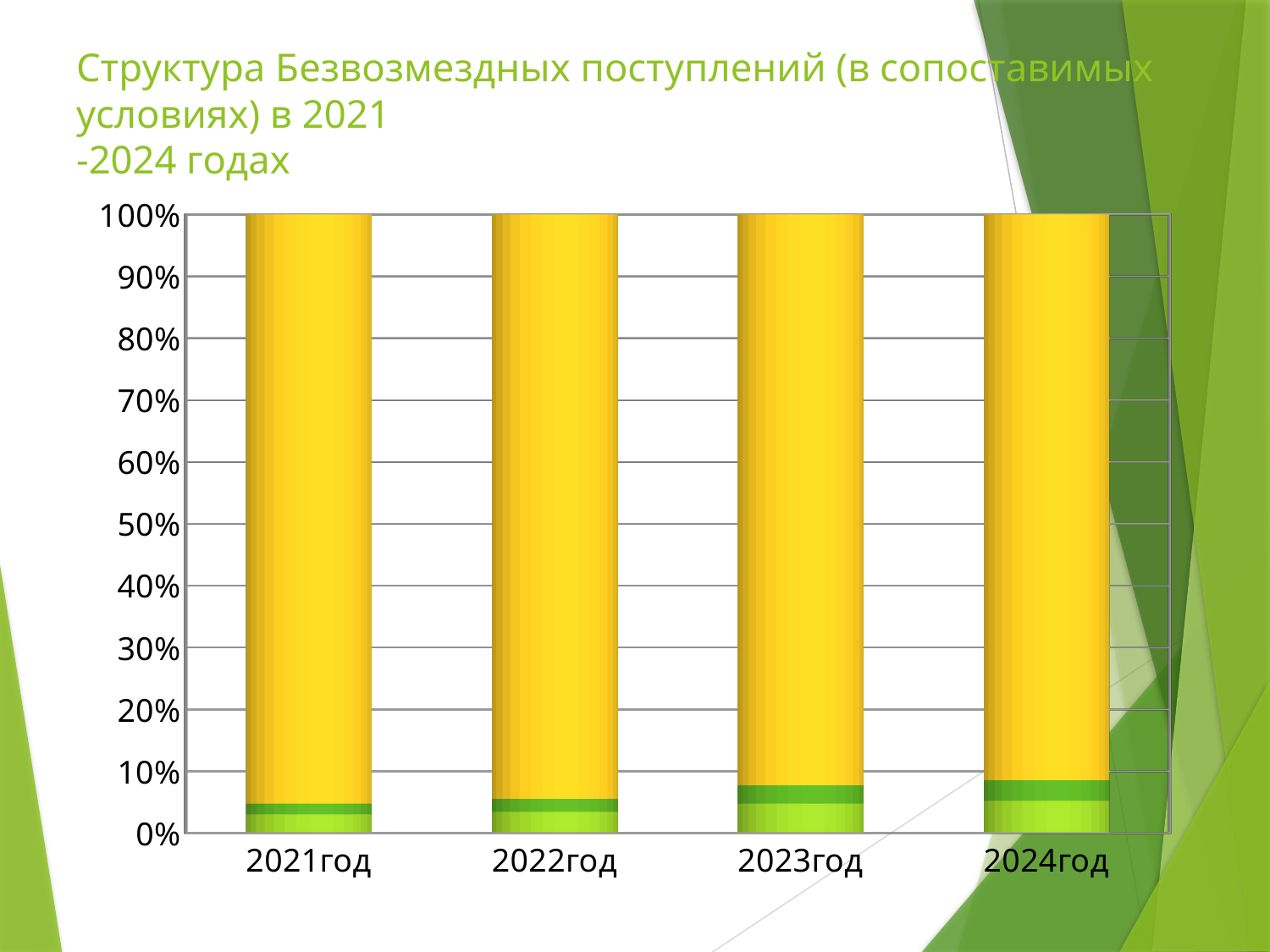
How many years (categories) are shown on the x axis of the chart? 4 Is the combined green portion of the bar for 2024год greater or less than 10%? less Does the green portion at the bottom of the bars rise or fall from 2021год to 2024год? rise What is the label of the first category on the x axis? 2021год Is the combined green portion of the bar for 2021год greater or less than 10%? less What is the highest value shown on the y axis? 100% What is the label of the last category on the x axis? 2024год Which year has the largest green portion at the bottom of its bar, 2021год or 2024год? 2024год What kind of chart is shown on the slide? bar chart Is the yellow segment for 2021год greater or less than 90%? greater